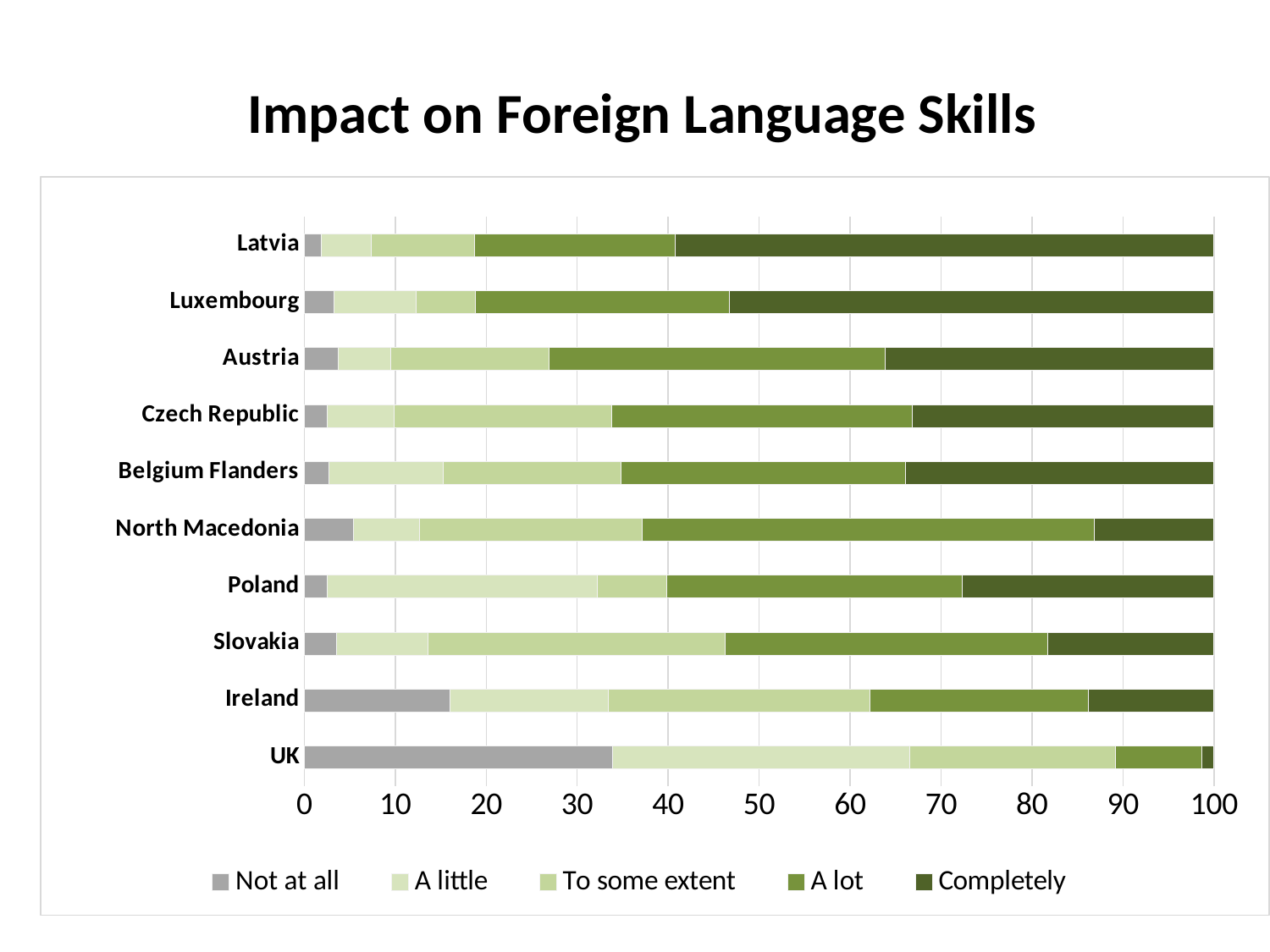
Is the 'Not at all' value for UK greater or less than 30? greater Which country has the largest 'Completely' segment? Latvia How many series does the legend list? 5 Which country has the smallest 'Completely' segment? UK How many countries are listed on the chart? 10 What is the total of the stacked bar for Latvia? 100 Is the 'Not at all' value for Ireland greater or less than 10? greater What is the title of the chart? Impact on Foreign Language Skills Which has a larger 'Not at all' segment, Ireland or UK? UK What kind of chart is shown on the slide? Stacked bar chart Is the 'Completely' value for UK greater or less than 10? less Which country has the largest 'Not at all' segment? UK